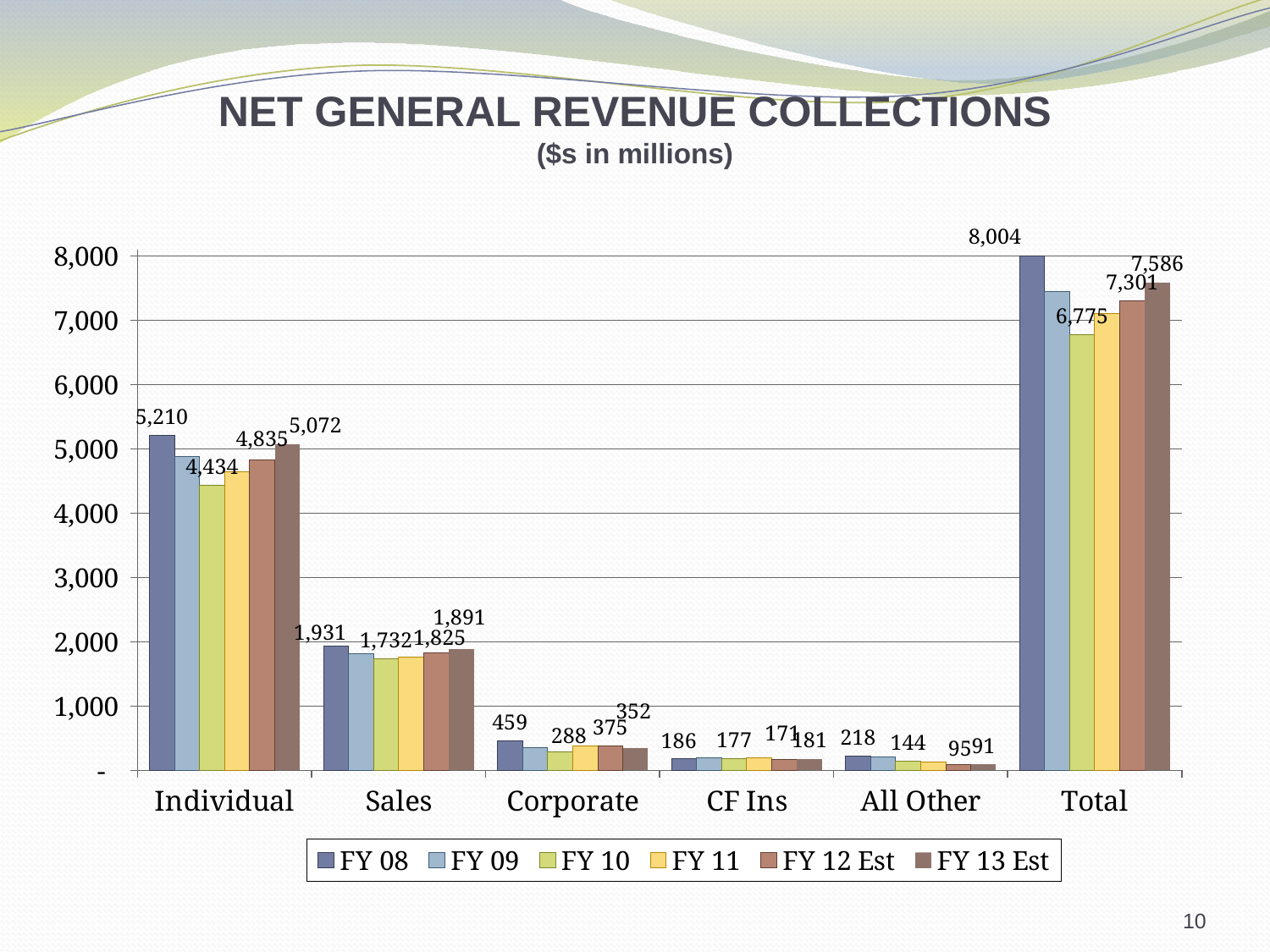
What kind of chart is shown on the slide? Bar chart How many series does the legend list? 6 Which category has the lowest value in FY 08? CF Ins How many categories are shown on the x axis? 6 Is the value for Total in FY 09 greater or less than 7,000? greater Which is larger for Sales: the FY 08 value or the FY 13 Est value? FY 08 Which category has the highest value in FY 08? Total What is the value for All Other in FY 10? 144 What is the value for Corporate in FY 08? 459 What is the value for Individual in FY 13 Est? 5,072 What is the difference between the Total value in FY 08 and in FY 13 Est? 418 What is the value for Total in FY 08? 8,004